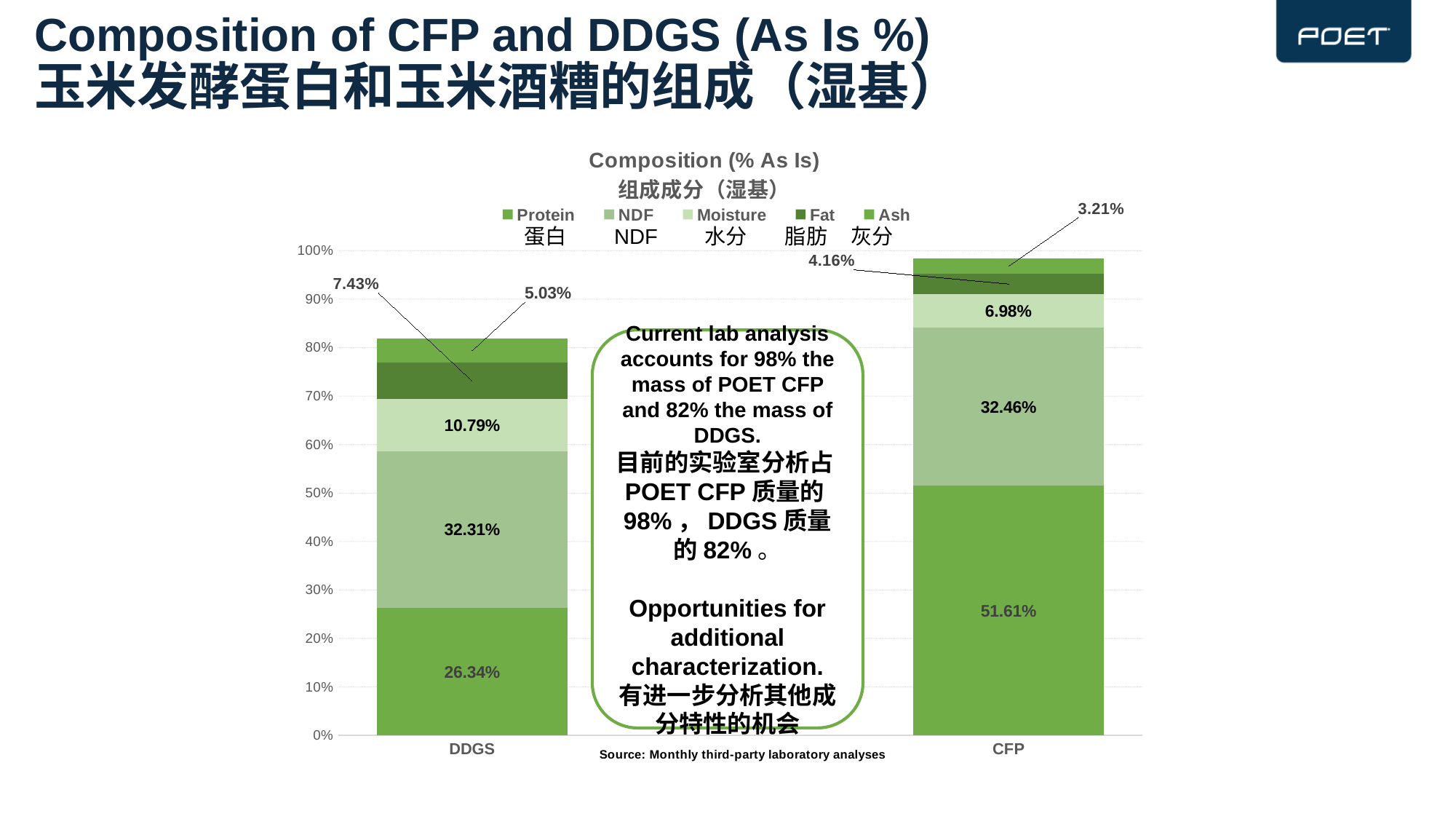
Which has the higher Moisture value, DDGS or CFP? DDGS What is the NDF value for DDGS? 32.31% How much higher is the Protein value for CFP than for DDGS? 25.27 percentage points How many series does the legend list? 5 Which component is the smallest in the DDGS bar? Ash What is the Protein value for CFP? 51.61% What is the total of the DDGS stacked bar? 81.90% What is the Fat value for DDGS? 7.43% What is the Moisture value for CFP? 6.98% Which component is the largest in the CFP bar? Protein What kind of chart is shown on the slide? Stacked bar chart What is the Ash value for CFP? 3.21%